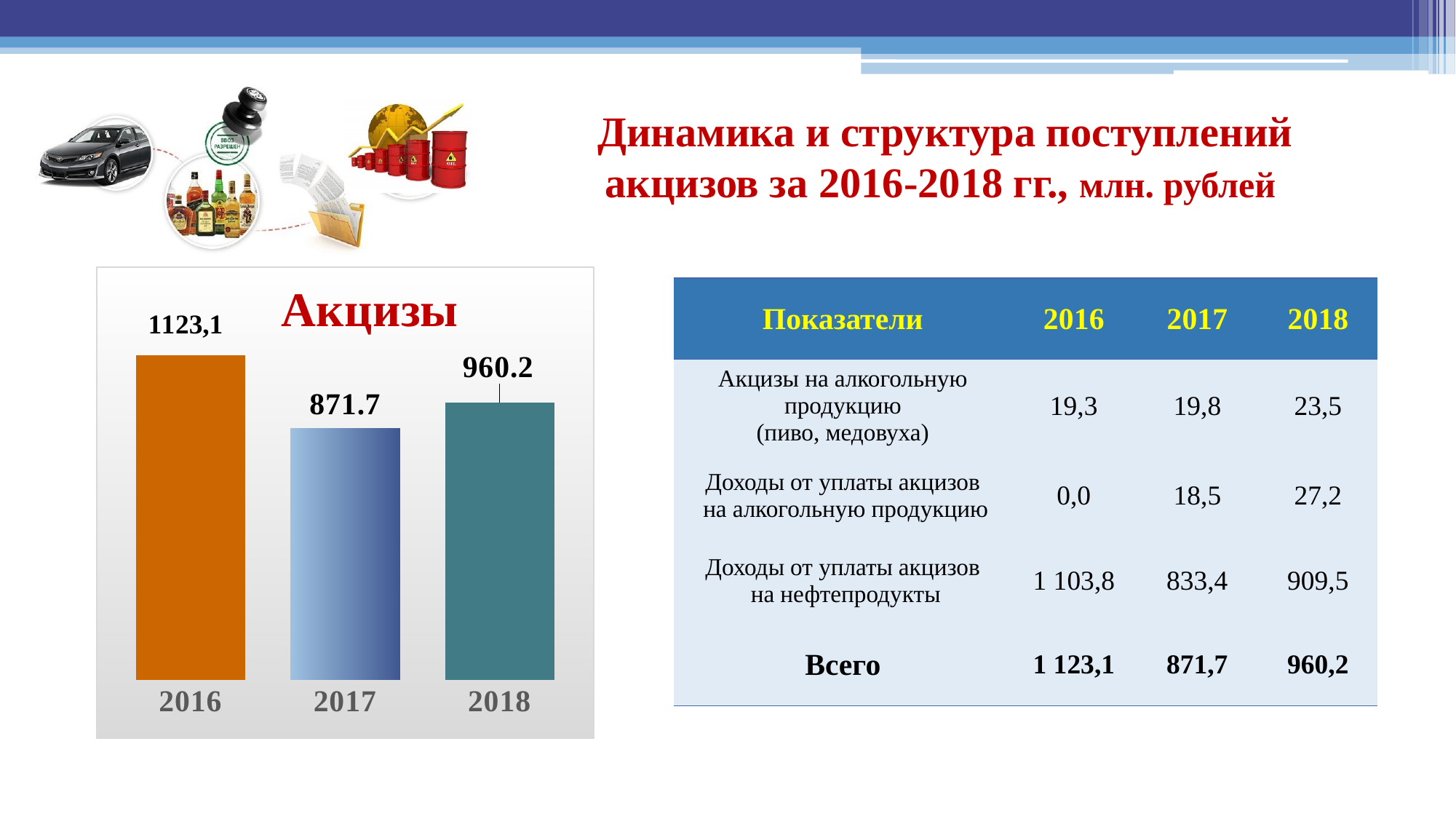
Which year has the highest value in the Акцизы chart? 2016 Which year has the lowest value in the Акцизы chart? 2017 What kind of chart is the Акцизы chart? bar chart In the Акцизы chart, does the value rise or fall from 2016 to 2017? fall What is the value shown for 2016 in the Акцизы chart? 1123,1 What is the difference between the 2018 and 2017 values in the Акцизы chart? 88.5 In the Акцизы chart, which year has the larger value, 2017 or 2018? 2018 What is the value shown for 2018 in the Акцизы chart? 960.2 How many years (bars) are shown in the Акцизы chart? 3 In the Акцизы chart, which year has the larger value, 2016 or 2018? 2016 What is the value shown for 2017 in the Акцизы chart? 871.7 What is the difference between the 2016 and 2018 values in the Акцизы chart? 162.9